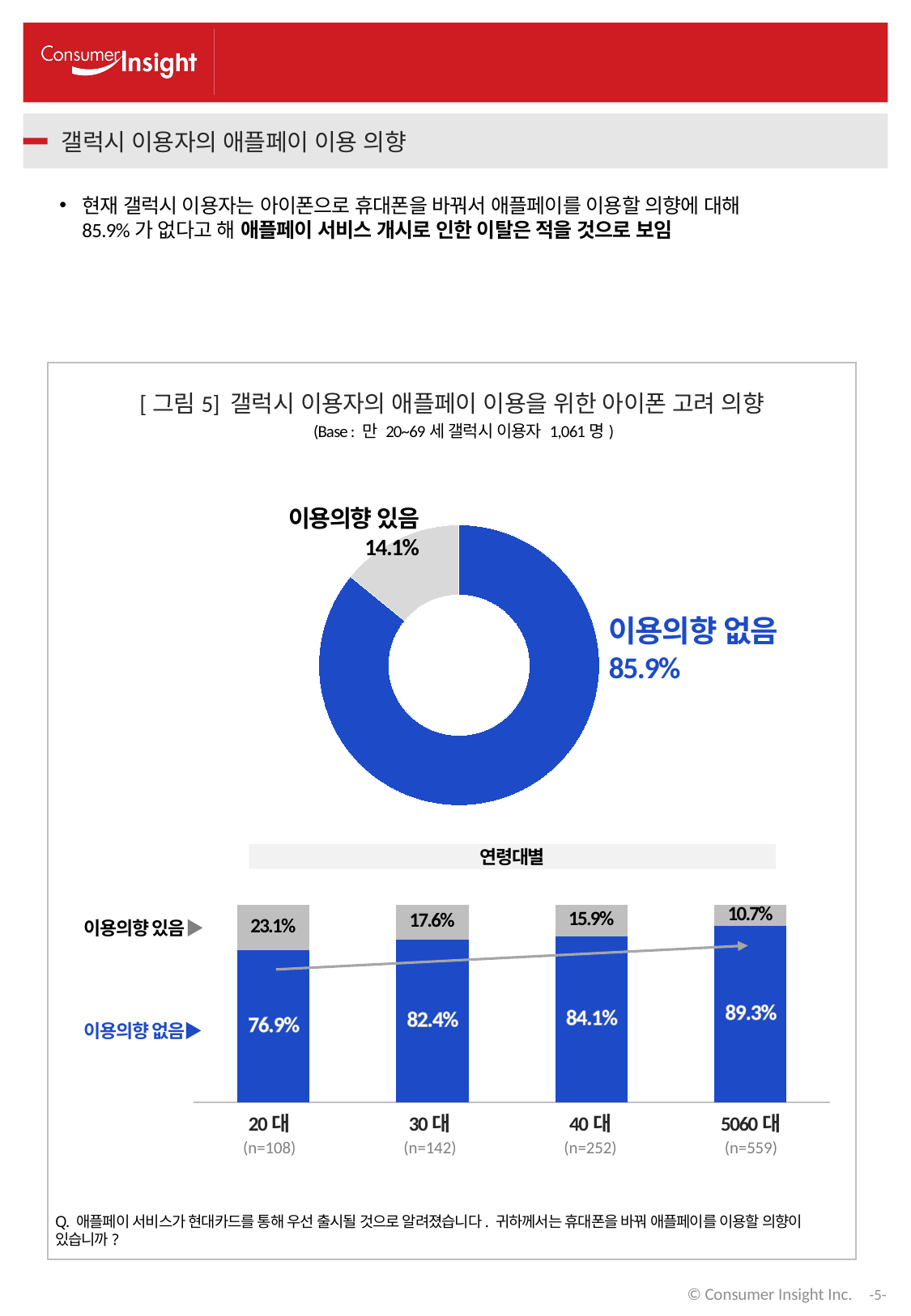
In the bar chart by age group (연령대별), what is the difference between the 이용의향 없음 values for 5060대 and 20대? 12.4 percentage points In the bar chart by age group (연령대별), which is larger: the 이용의향 있음 value for 30대 or for 40대? 30대 What type of chart is the top chart on the slide? Donut (pie) chart In the donut chart at the top, what percentage is shown for 이용의향 있음? 14.1% In the bar chart by age group (연령대별), does the 이용의향 없음 value rise or fall as age increases from 20대 to 5060대? Rises In the bar chart by age group (연령대별), what is the 이용의향 있음 value for 5060대? 10.7% In the bar chart by age group (연령대별), which age group has the lowest 이용의향 있음 value? 5060대 In the bar chart by age group (연령대별), how many age groups are shown? 4 In the bar chart by age group (연령대별), what is the 이용의향 없음 value for 20대? 76.9% In the donut chart at the top, what percentage of Galaxy users have no intention to use Apple Pay (이용의향 없음)? 85.9% In the bar chart by age group (연령대별), which age group has the highest 이용의향 없음 value? 5060대 What is the sample size (n) shown for 40대 in the bar chart by age group? n=252